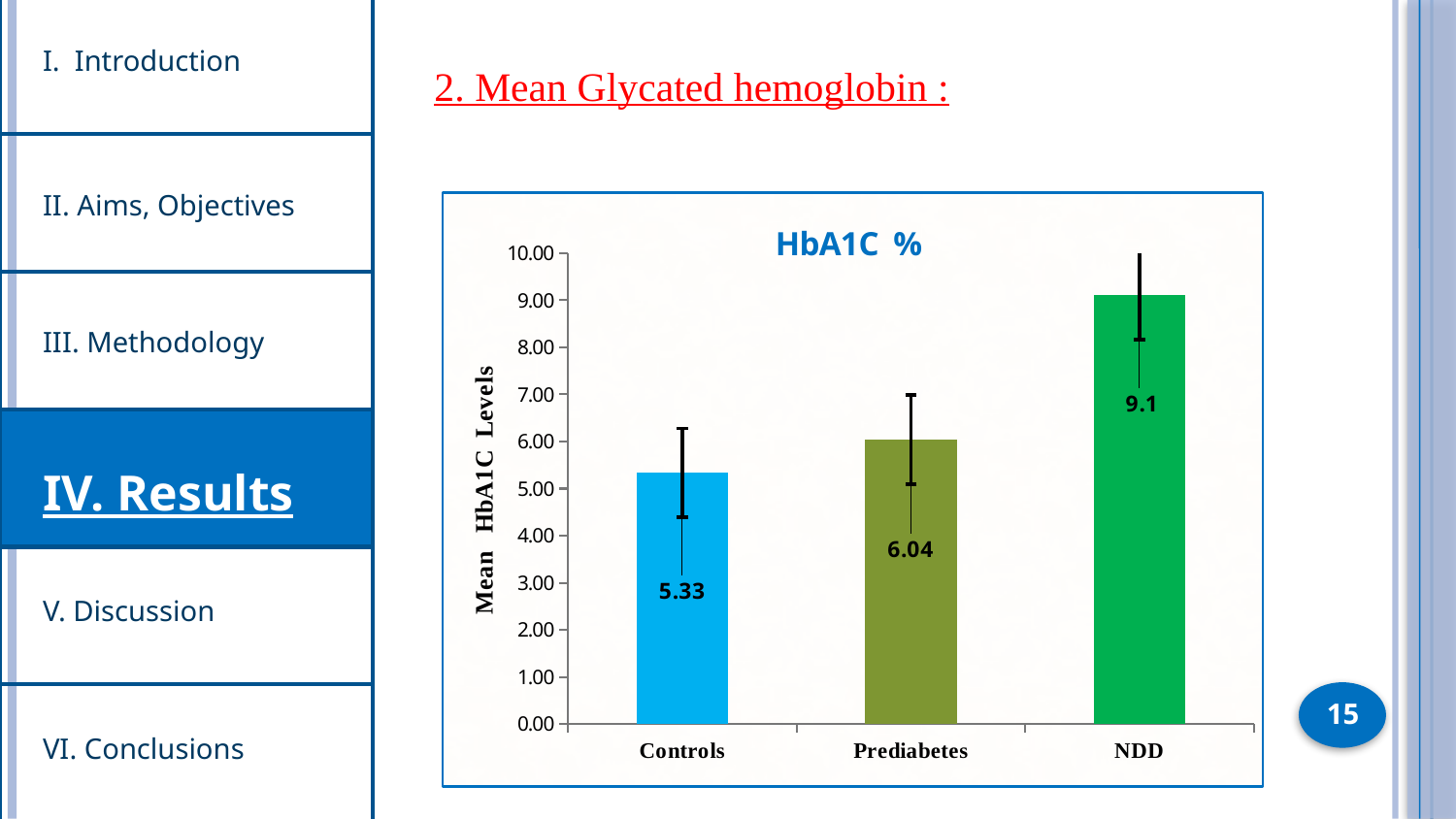
Which group has a larger mean HbA1C value, Prediabetes or NDD? NDD What kind of chart is shown on the slide? bar chart What is the title of the chart? HbA1C % Is the mean HbA1C value for NDD greater or less than 8.00? greater Which group has the highest mean HbA1C level? NDD What is the mean HbA1C value for NDD? 9.1 What is the difference between the mean HbA1C values for NDD and Controls? 3.77 Which group has the lowest mean HbA1C level? Controls What is the difference between the mean HbA1C values for Prediabetes and Controls? 0.71 What is the mean HbA1C value for Prediabetes? 6.04 How many groups are shown on the x axis of the chart? 3 What is the mean HbA1C value for Controls? 5.33